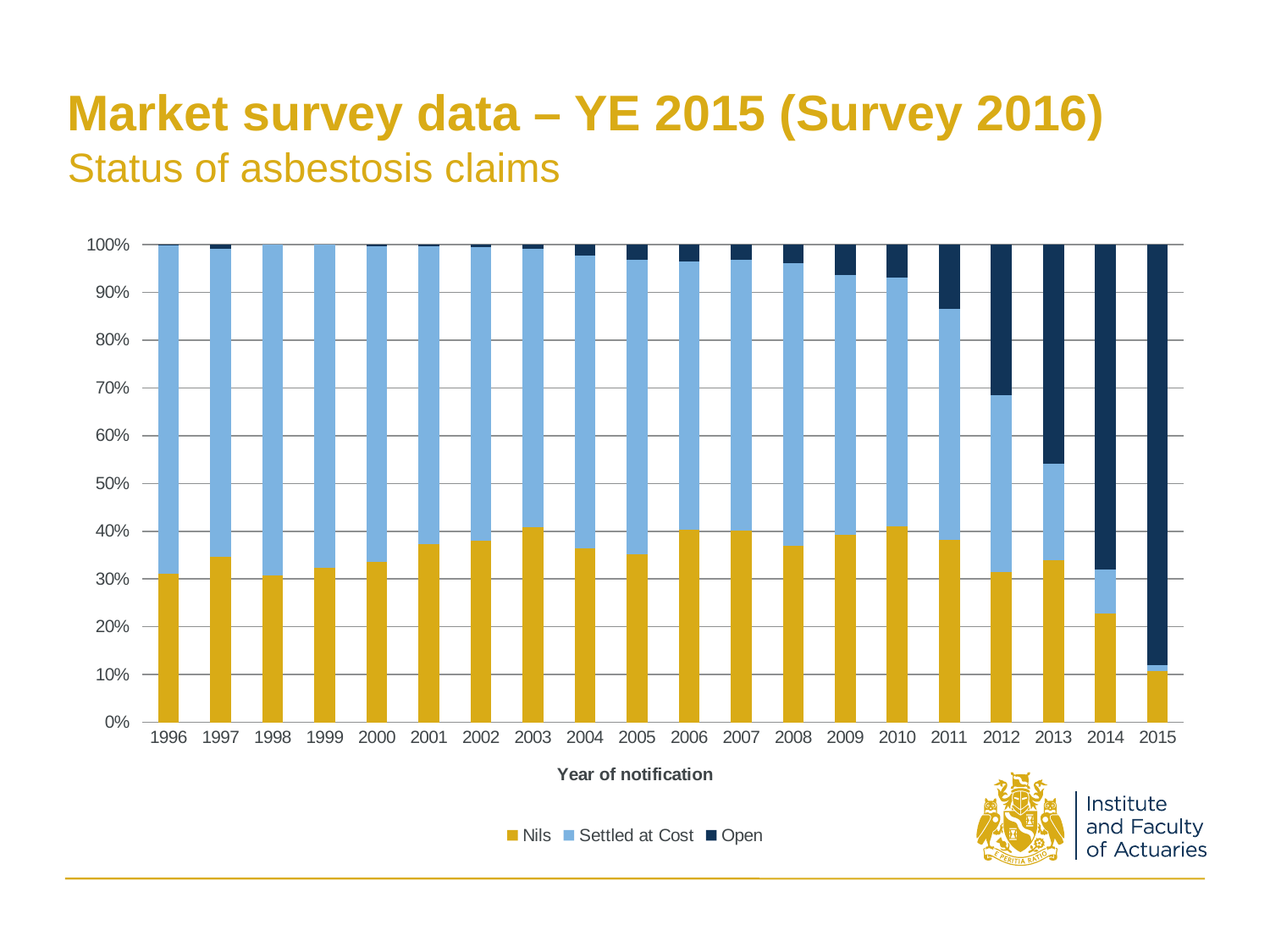
How many years of notification are shown on the x axis? 20 What is the label of the x axis? Year of notification Does the Open share rise or fall as the year of notification moves from 2009 to 2015? Rise Is the Nils share for 1996 greater or less than 40%? less Which year of notification has the smallest Nils share? 2015 Is the Settled at Cost share for 1996 greater or less than 60%? greater Is the Open share for 2015 greater or less than 80%? greater What are the three series named in the legend? Nils, Settled at Cost, Open How many series does the legend list? 3 Which is larger, the Open share for 2013 or the Open share for 2010? 2013 Which year of notification has the largest Open share? 2015 What kind of chart is shown on the slide? Stacked bar chart